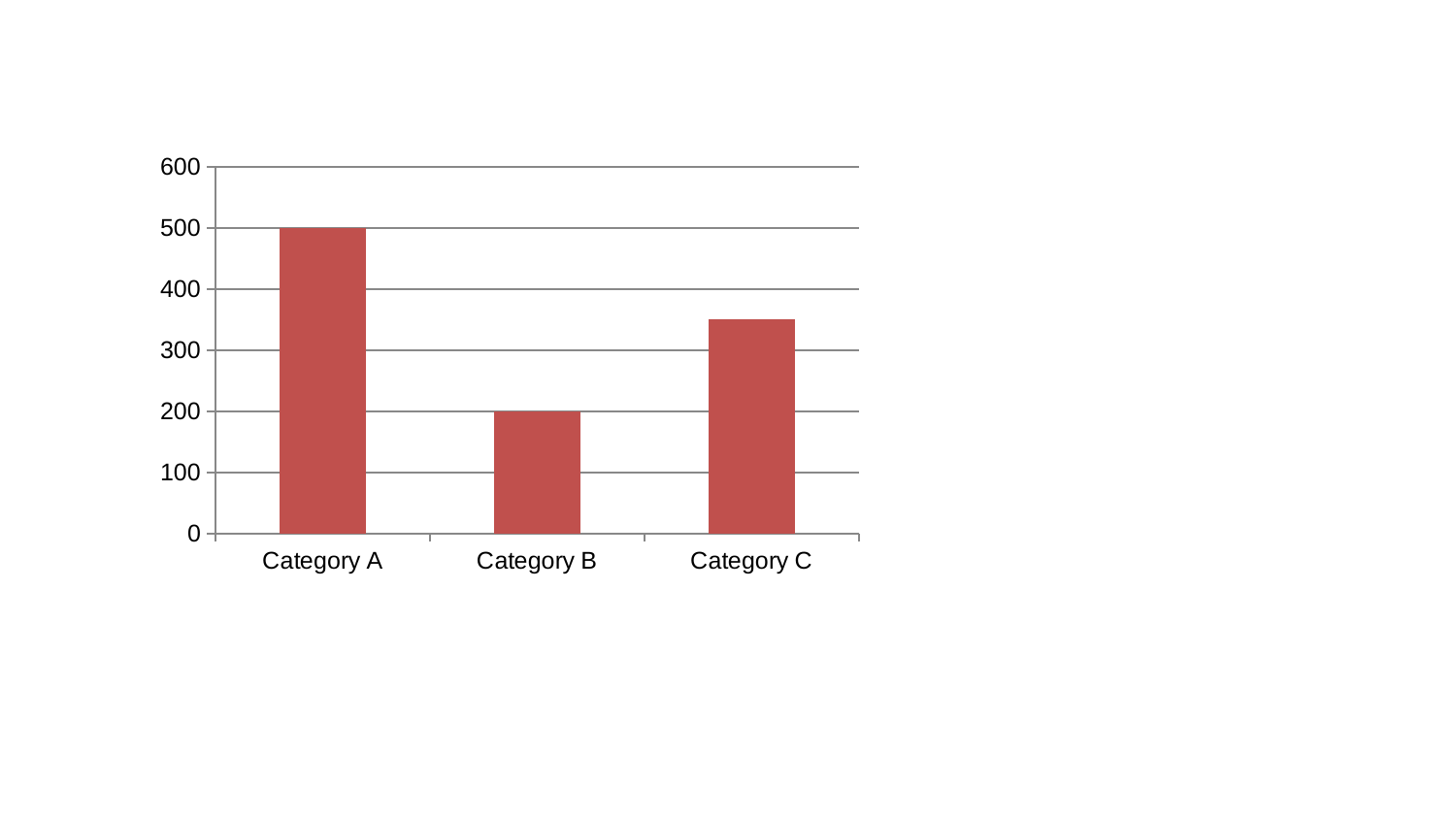
Which category has the highest value? Category A Is the value for Category C greater or less than 300? greater What is the value for Category A? 500 Is the value for Category C greater or less than 400? less What is the highest value shown on the y axis? 600 What colour are the bars in the chart? red What type of chart is shown on the slide? bar chart How many categories are shown on the x axis? 3 What is the value for Category B? 200 Which category has the lowest value? Category B Which is larger, the value for Category C or the value for Category B? Category C What is the difference between the values for Category A and Category B? 300